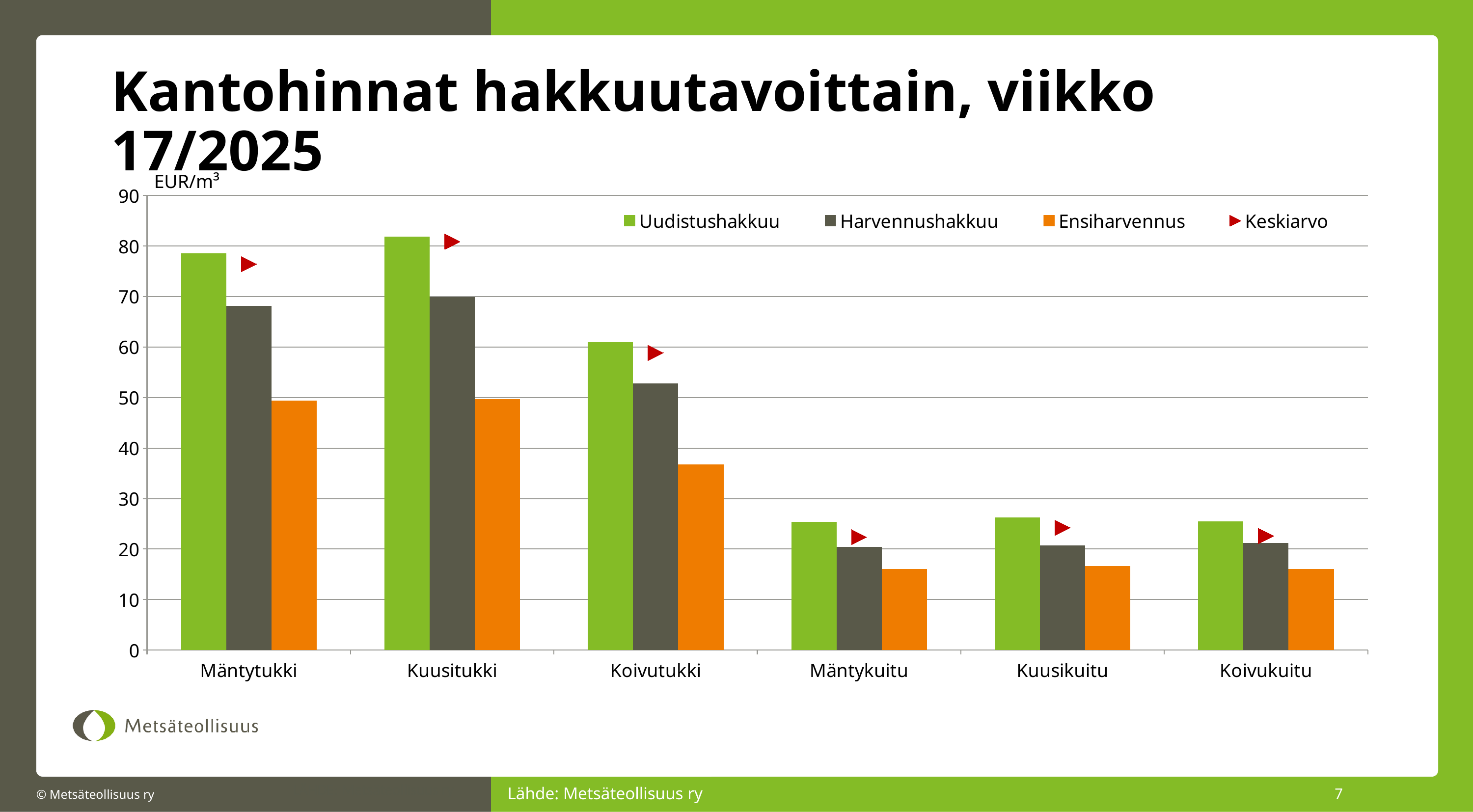
Which category has the highest Uudistushakkuu value? Kuusitukki How many categories are shown on the x axis? 6 What kind of chart is shown on the slide? bar chart Is the Uudistushakkuu value for Mäntytukki greater or less than 80? less For Koivutukki, which is larger: the Uudistushakkuu value or the Harvennushakkuu value? Uudistushakkuu Is the Harvennushakkuu value for Koivutukki greater or less than 50? greater Which is larger: the Ensiharvennus value for Mäntytukki or for Koivutukki? Mäntytukki Is the Uudistushakkuu value for Kuusitukki greater or less than 80? greater How many series does the legend list? 4 What unit is shown on the y axis of the chart? EUR/m³